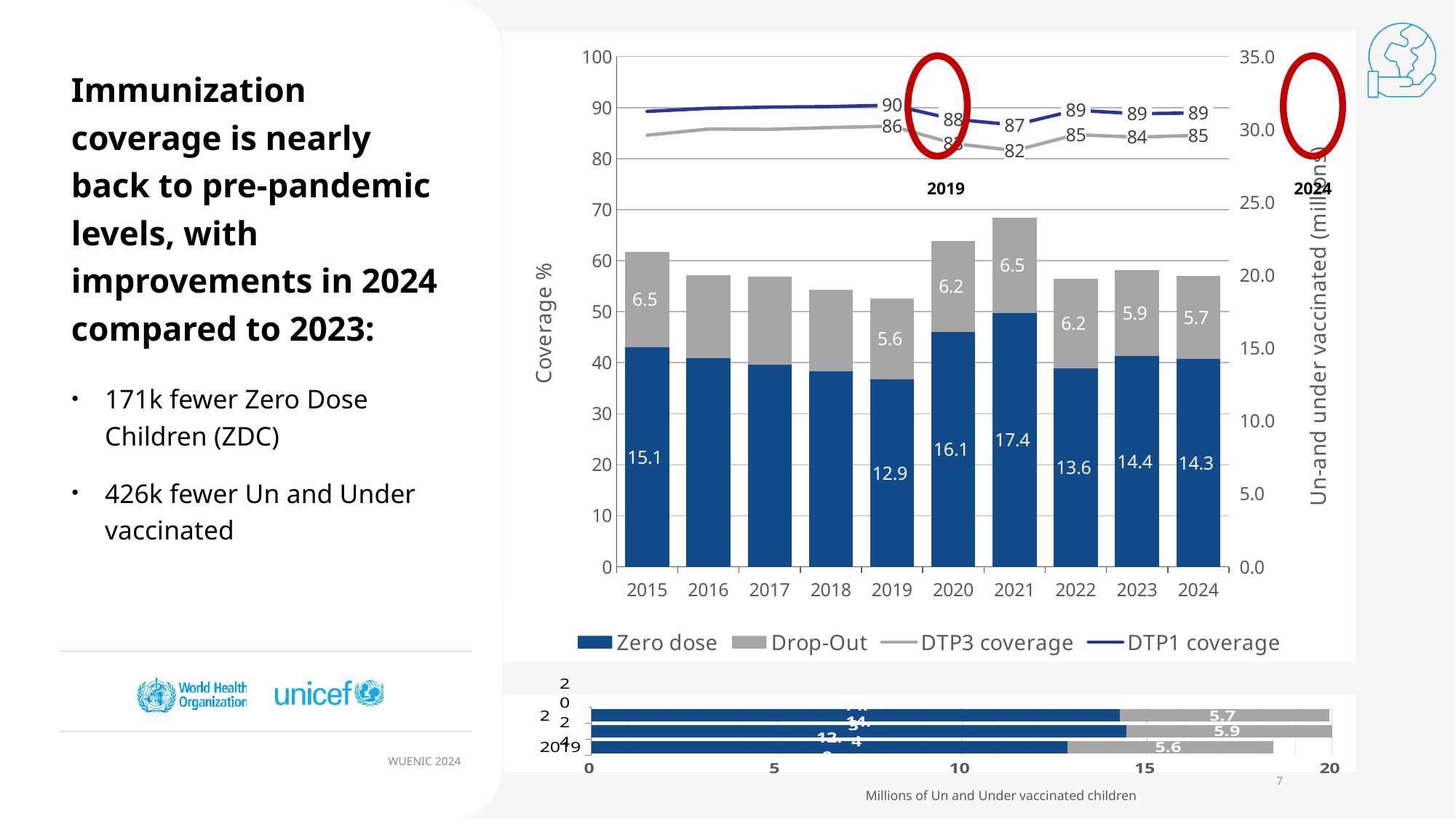
In the main chart, what is the DTP3 coverage value for 2021? 82 In the main chart, what is the difference between the Zero dose values for 2023 and 2024? 0.1 In the main chart, does DTP1 coverage rise or fall from 2019 to 2021? fall How many years are shown on the x axis of the main chart? 10 In the main chart, what is the DTP1 coverage value for 2019? 90 In the main chart, which year has the higher DTP1 coverage, 2020 or 2021? 2020 How many series does the legend of the main chart list? 4 In the main chart, what is the Zero dose value for 2021? 17.4 In the main chart, what is the total of the stacked bar for 2021 (Zero dose plus Drop-Out)? 23.9 In the main chart, what is the Drop-Out value for 2024? 5.7 In the main chart, which year has the lowest Zero dose value? 2019 In the main chart, which year has the highest Zero dose value? 2021